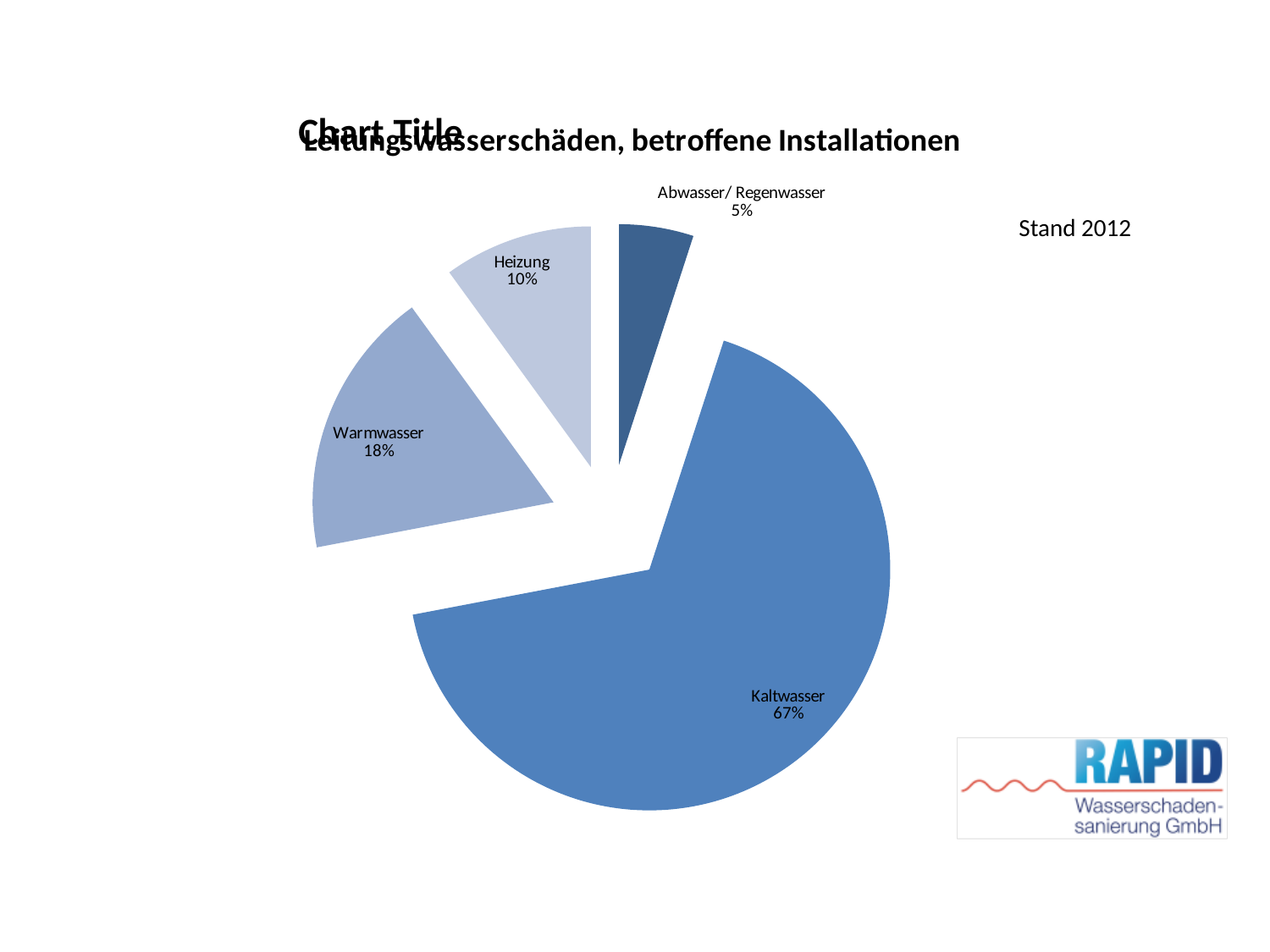
What year is given as the data status (Stand) next to the chart? 2012 What share of the pie does Heizung have? 10% How many slices does the pie chart have? 4 Which category has the largest slice of the pie? Kaltwasser Which category has the smallest slice of the pie? Abwasser/ Regenwasser What share of the pie does Warmwasser have? 18% What share of the pie does Kaltwasser have? 67% What is the difference in percentage points between Heizung and Abwasser/ Regenwasser? 5 Which is larger, the share for Warmwasser or the share for Heizung? Warmwasser What kind of chart is shown on the slide? pie chart What is the difference in percentage points between Kaltwasser and Warmwasser? 49